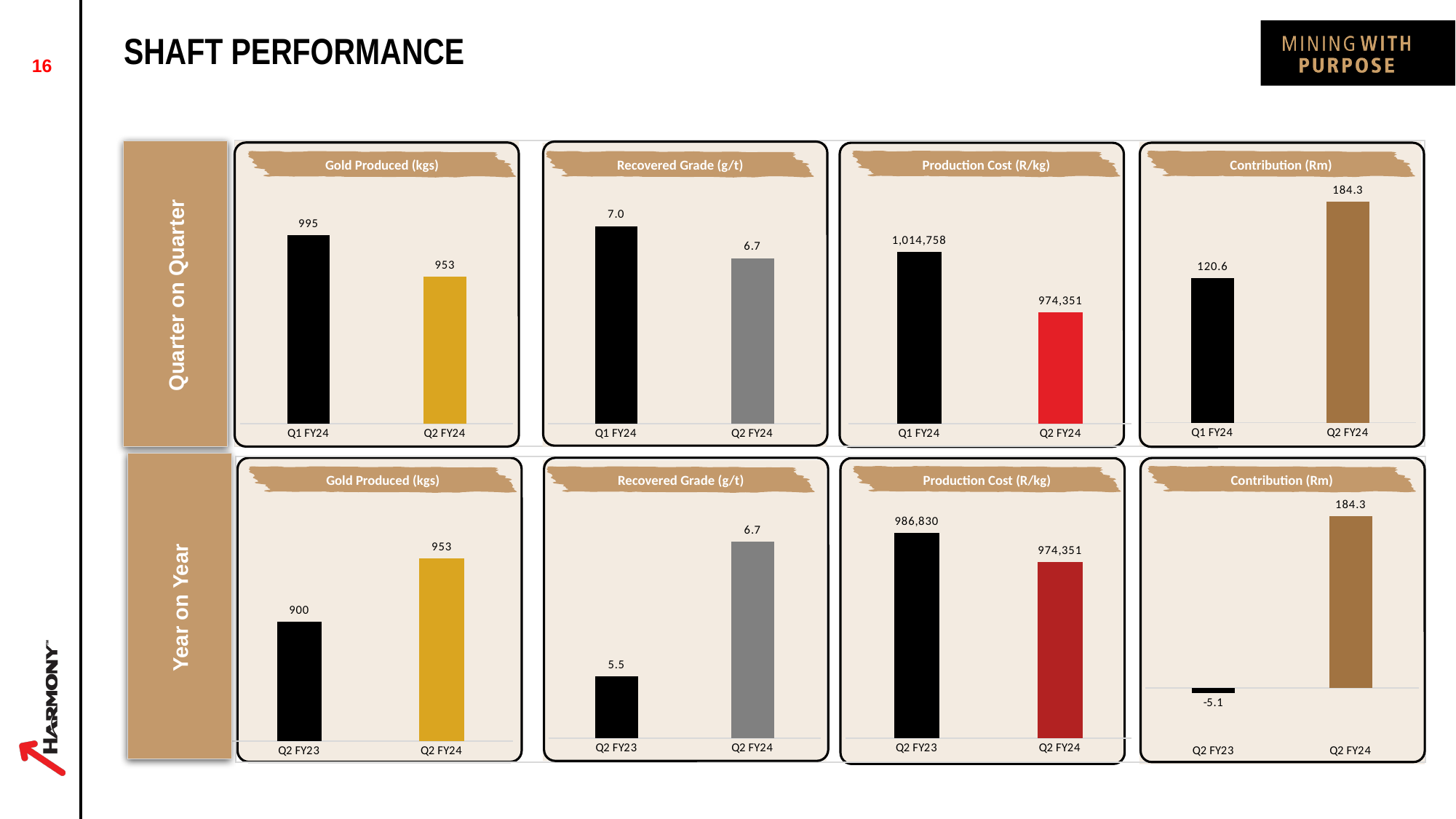
What type of chart is the Quarter on Quarter Contribution (Rm) chart? Bar chart In the Quarter on Quarter Contribution (Rm) chart, what is the difference between Q2 FY24 and Q1 FY24? 63.7 In the Quarter on Quarter Production Cost (R/kg) chart, does the value fall or rise from Q1 FY24 to Q2 FY24? Fall In the Quarter on Quarter Production Cost (R/kg) chart, what is the value for Q1 FY24? 1,014,758 In the Year on Year Production Cost (R/kg) chart, which period has the lowest value? Q2 FY24 In the Year on Year Contribution (Rm) chart, what is the value for Q2 FY23? -5.1 In the Quarter on Quarter Recovered Grade (g/t) chart, what is the value for Q1 FY24? 7.0 In the Year on Year Gold Produced (kgs) chart, what is the difference between Q2 FY24 and Q2 FY23? 53 In the Quarter on Quarter Gold Produced (kgs) chart, which period has the highest value? Q1 FY24 In the Quarter on Quarter Gold Produced (kgs) chart, what is the value for Q2 FY24? 953 How many bars are in the Year on Year Production Cost (R/kg) chart? 2 In the Year on Year Recovered Grade (g/t) chart, which period has the higher value, Q2 FY23 or Q2 FY24? Q2 FY24